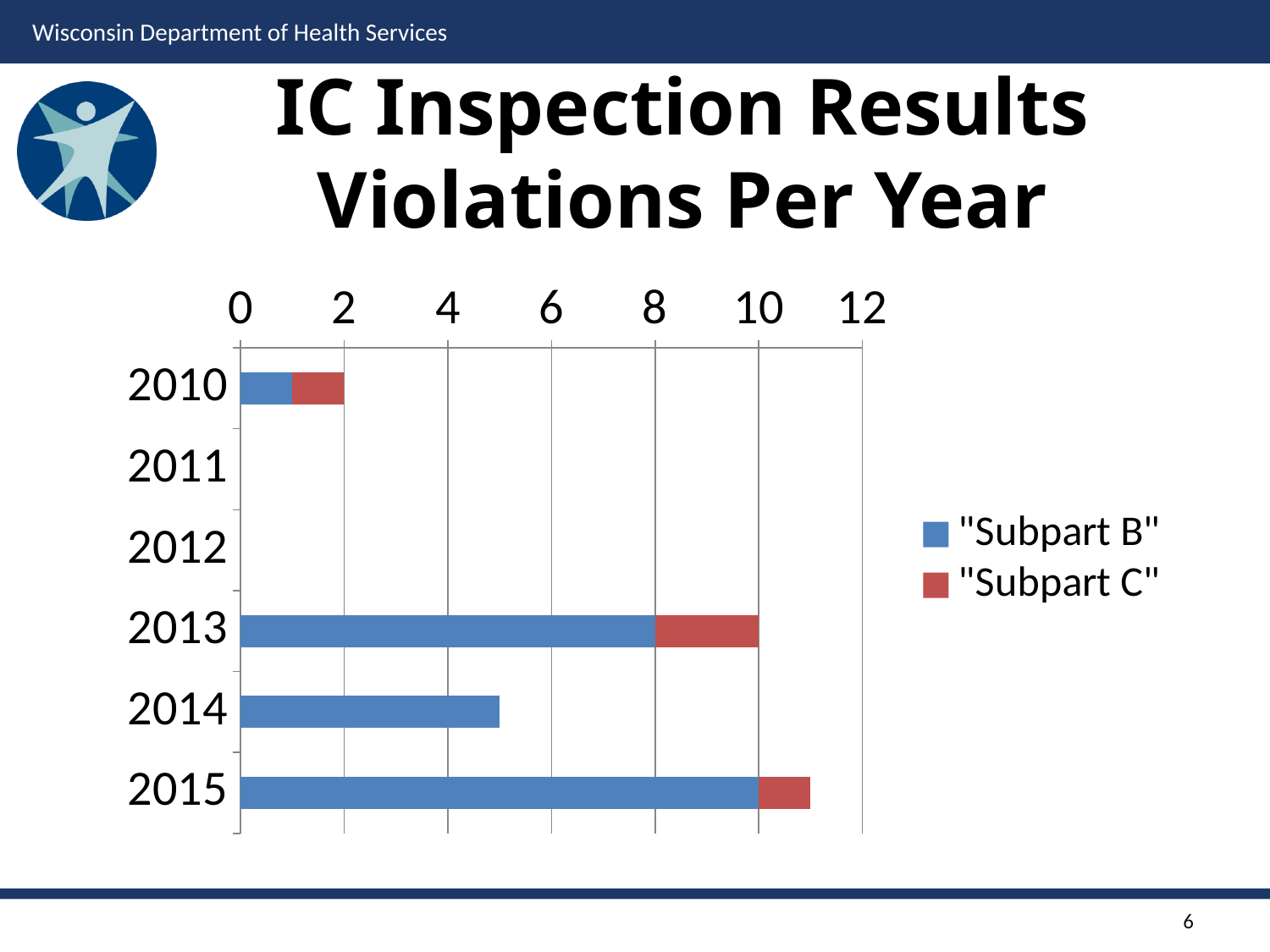
What is the "Subpart C" value for 2013? 2 Which year has the highest total number of violations? 2015 What colour represents "Subpart C" in the legend? red Is the "Subpart B" value for 2014 greater or less than 4? greater What type of chart is shown on the slide? bar chart What is the "Subpart B" value for 2013? 8 What is the total of the stacked bar for 2010? 2 How many series does the legend list? 2 What is the total of the stacked bar for 2013? 10 How many years are shown on the vertical axis? 6 Which year has the larger "Subpart B" value, 2013 or 2014? 2013 What is the "Subpart B" value for 2015? 10